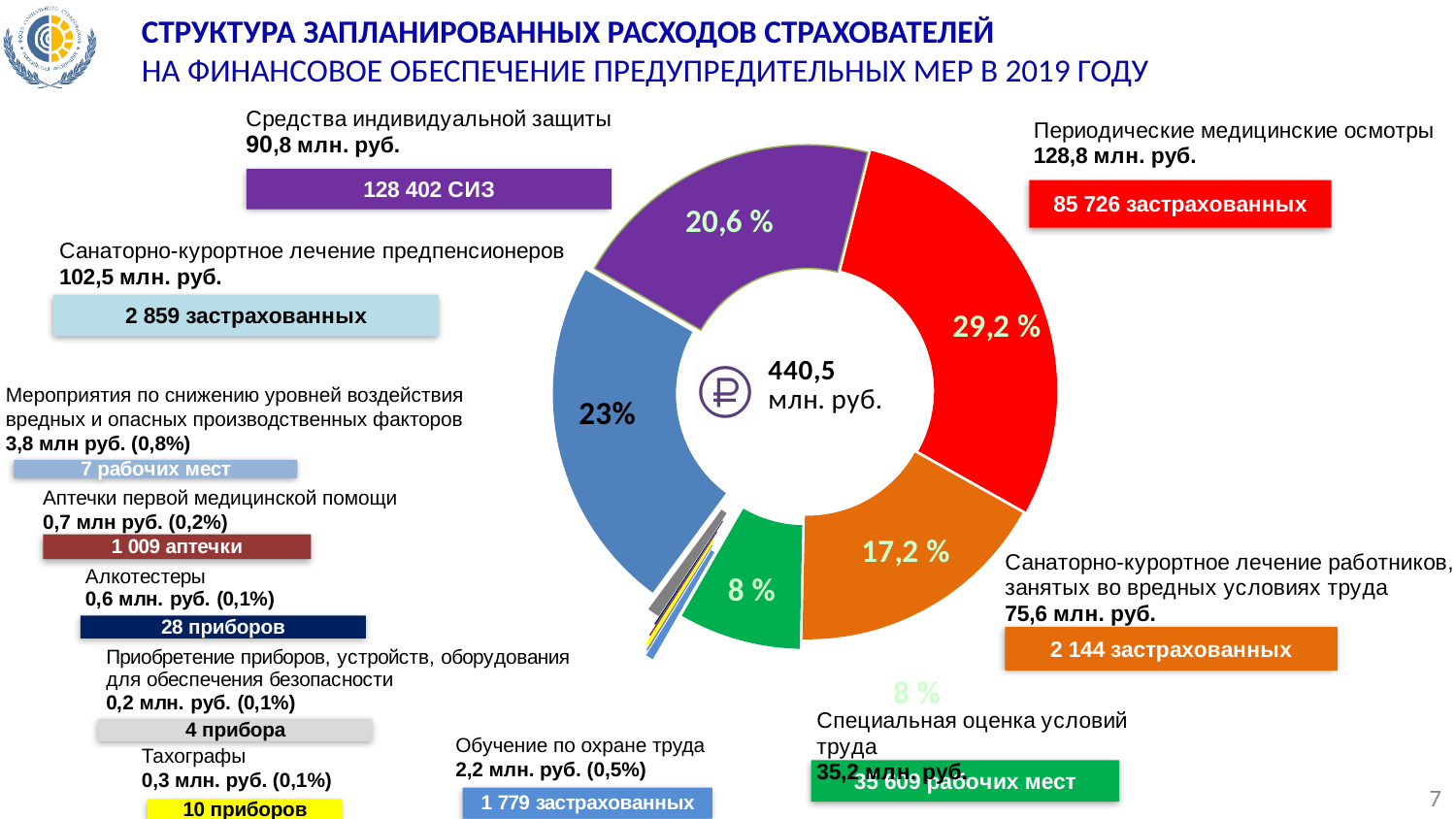
What is the planned amount for Средства индивидуальной защиты? 90,8 млн. руб. What is the planned amount for Санаторно-курортное лечение предпенсионеров? 102,5 млн. руб. What is the difference in percentage points between the red slice (29,2 %) and the orange slice (17,2 %)? 12 percentage points What percentage is shown on the purple slice of the donut chart? 20,6 % What percentage is shown on the green slice of the donut chart? 8 % Which category has the largest share of the planned expenses? Периодические медицинские осмотры What percentage is shown on the orange slice of the donut chart? 17,2 % What percentage is shown on the blue slice of the donut chart? 23% What kind of chart is shown on the slide? donut (pie) chart What share of the planned expenses does the red slice (Периодические медицинские осмотры) represent? 29,2 % What total amount is shown in the centre of the donut chart? 440,5 млн. руб. Which slice is larger: the purple slice or the blue slice? the blue slice (23%)